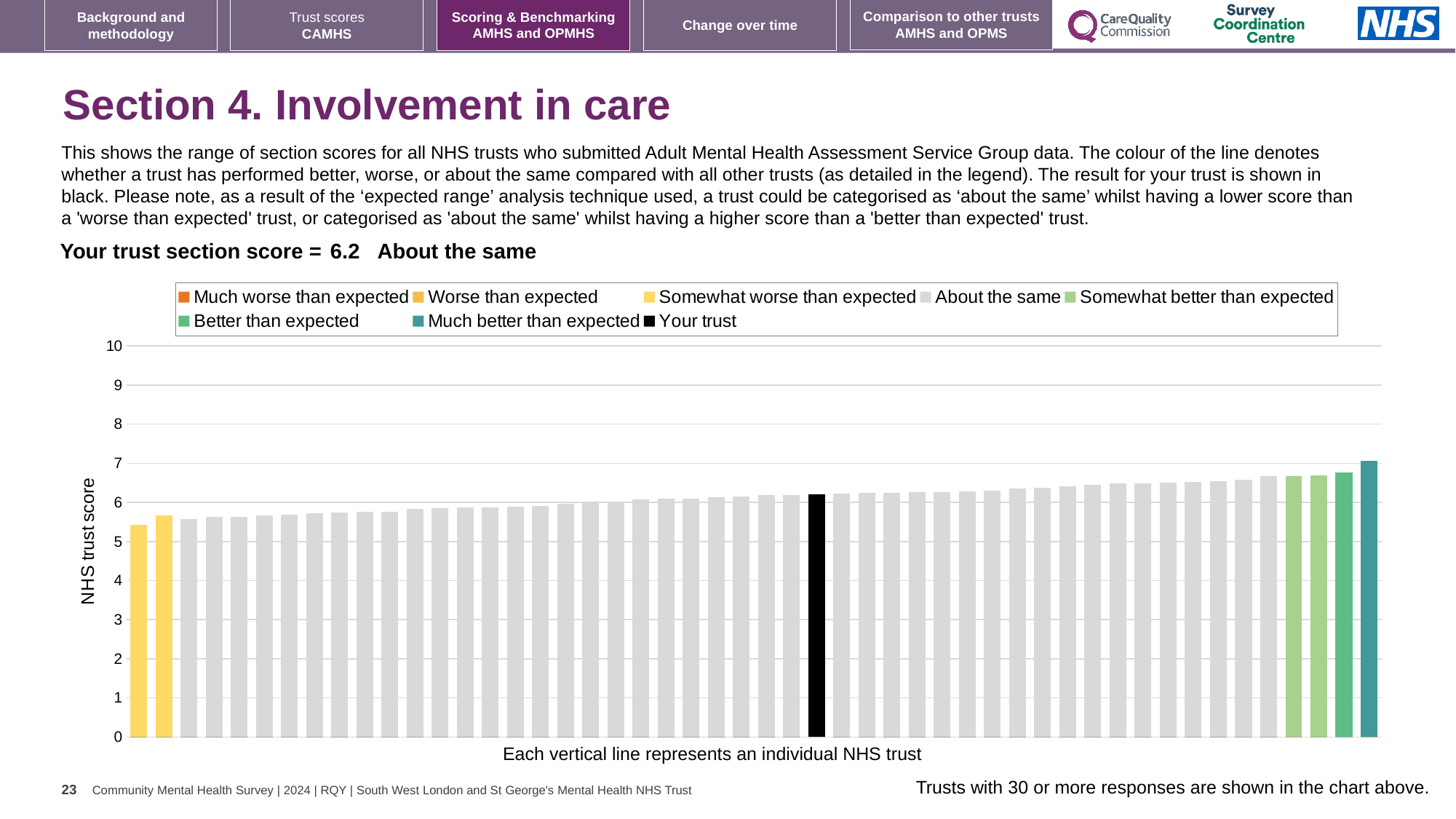
How many bars are shown in black? 1 What is the section score for your trust? 6.2 Is the value of the tallest bar (far right) greater or less than 6? greater What is the label on the vertical axis? NHS trust score How many entries does the legend list? 8 Is the value of the shortest bar (far left) greater or less than 5? greater Which category is your trust's section score placed in? About the same What kind of chart is shown on the slide? bar chart Which bar is taller, the leftmost bar or the rightmost bar? the rightmost bar What does the caption below the chart say each vertical line represents? an individual NHS trust Is the value for your trust (the black bar) greater or less than 6? greater Do the bar values rise or fall from left to right across the chart? rise